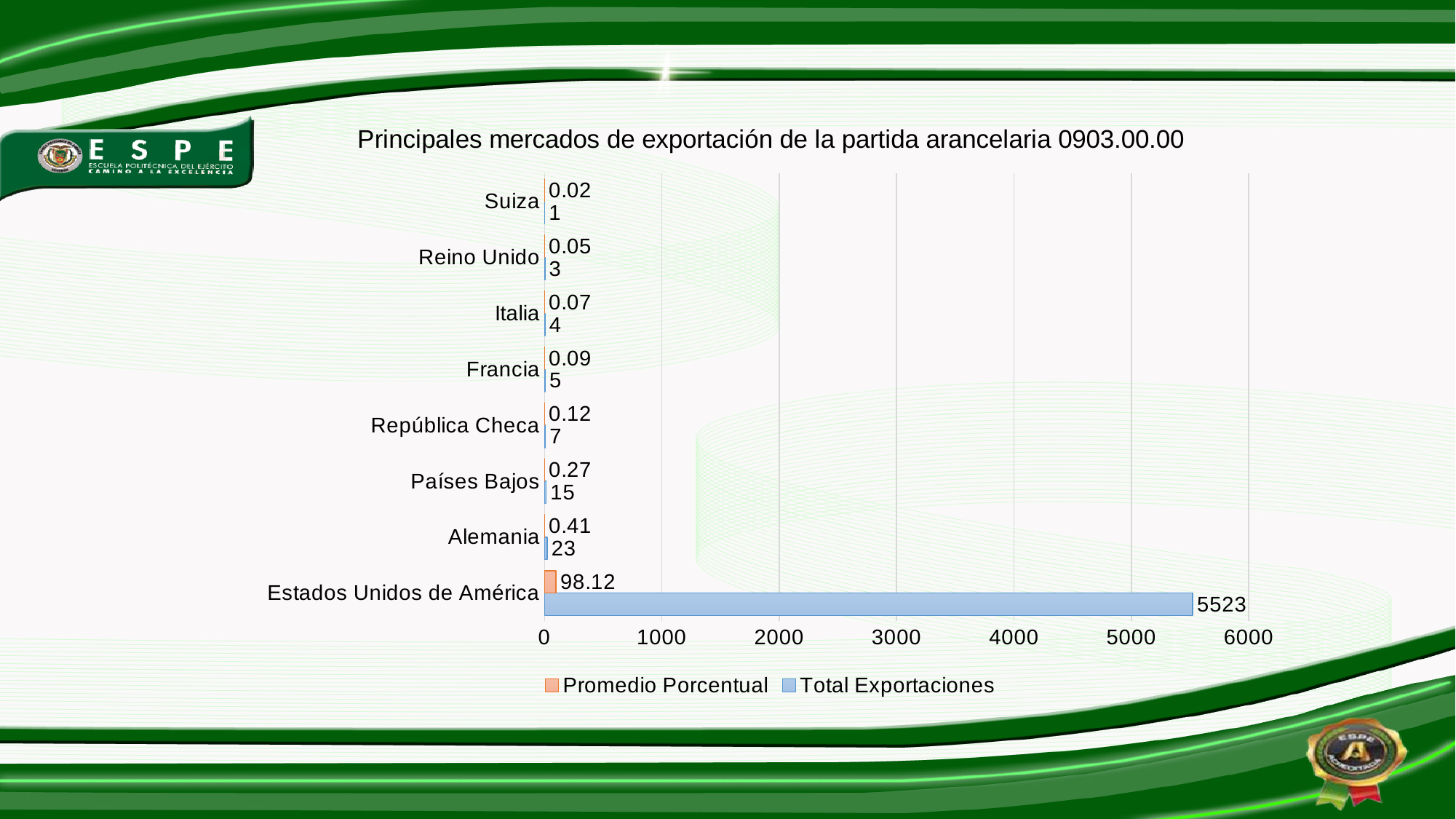
What is the Total Exportaciones value for Estados Unidos de América? 5523 What kind of chart is shown on the slide? Bar chart Which country has the lowest Total Exportaciones? Suiza What is the Promedio Porcentual value for Alemania? 0.41 What is the difference in Total Exportaciones between Alemania and Países Bajos? 8 Which country has the highest Total Exportaciones? Estados Unidos de América Is the Total Exportaciones value for Estados Unidos de América greater or less than 5000? greater How many series does the legend list? 2 What is the Total Exportaciones value for Países Bajos? 15 Which has a larger Total Exportaciones value, Italia or Francia? Francia How many countries are shown on the chart? 8 What is the Promedio Porcentual value for Suiza? 0.02